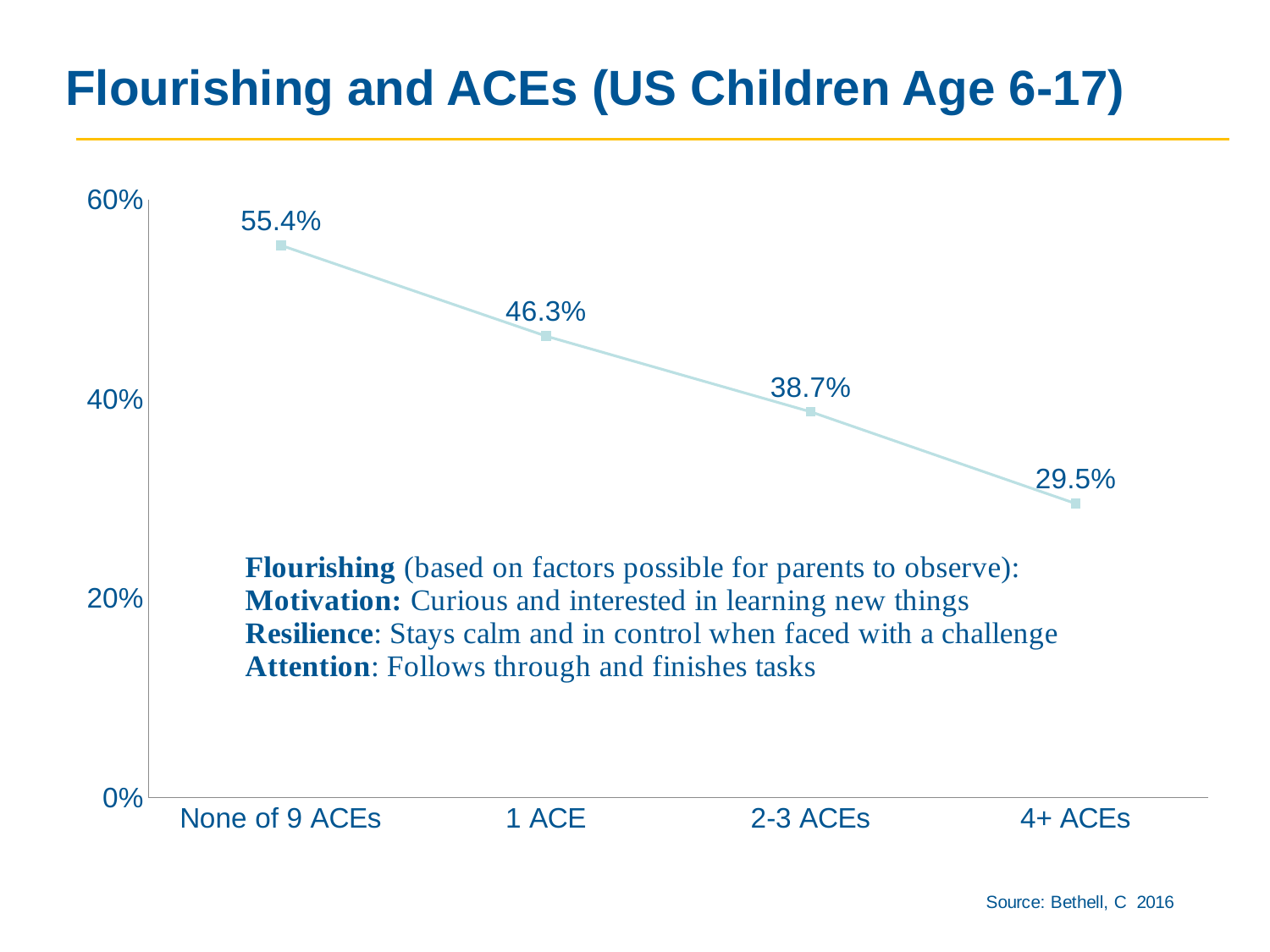
What kind of chart is shown on the slide? line chart Which ACE category has the lowest flourishing percentage? 4+ ACEs Which has a higher flourishing percentage: 1 ACE or 2-3 ACEs? 1 ACE Is the flourishing percentage for 2-3 ACEs greater or less than 40%? less Do the flourishing percentages rise or fall as the number of ACEs increases? fall What is the flourishing percentage for children with 4+ ACEs? 29.5% What is the flourishing percentage for children with none of 9 ACEs? 55.4% What is the flourishing percentage for children with 1 ACE? 46.3% How many ACE categories are plotted on the chart? 4 What is the flourishing percentage for children with 2-3 ACEs? 38.7% What is the difference in flourishing percentage between children with none of 9 ACEs and children with 4+ ACEs? 25.9% Which ACE category has the highest flourishing percentage? None of 9 ACEs